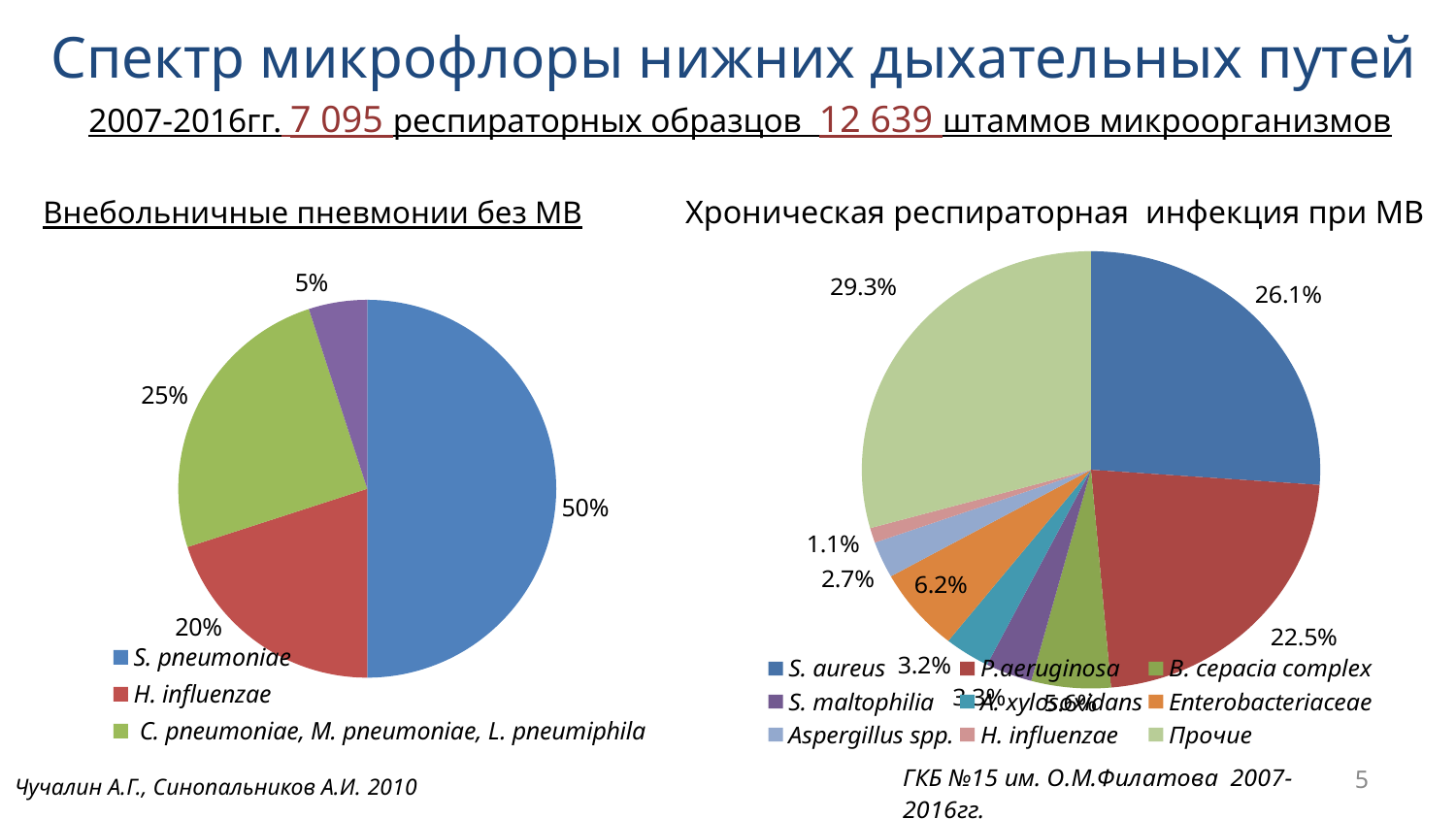
In the right chart 'Хроническая респираторная инфекция при МВ', what share does the 'Прочие' slice have? 29.3% In the left chart 'Внебольничные пневмонии без МВ', how many percentage points larger is the S. pneumoniae slice than the H. influenzae slice? 30 percentage points In the right chart 'Хроническая респираторная инфекция при МВ', what share does P. aeruginosa have? 22.5% In the left chart 'Внебольничные пневмонии без МВ', what share does H. influenzae have? 20% In the right chart 'Хроническая респираторная инфекция при МВ', which is larger: the S. aureus slice or the P. aeruginosa slice? S. aureus What kind of chart is the left chart, 'Внебольничные пневмонии без МВ'? Pie chart In the right chart 'Хроническая респираторная инфекция при МВ', which category has the smallest slice? H. influenzae In the right chart 'Хроническая респираторная инфекция при МВ', how many entries does the legend list? 9 In the left chart 'Внебольничные пневмонии без МВ', which legend category has the largest slice? S. pneumoniae